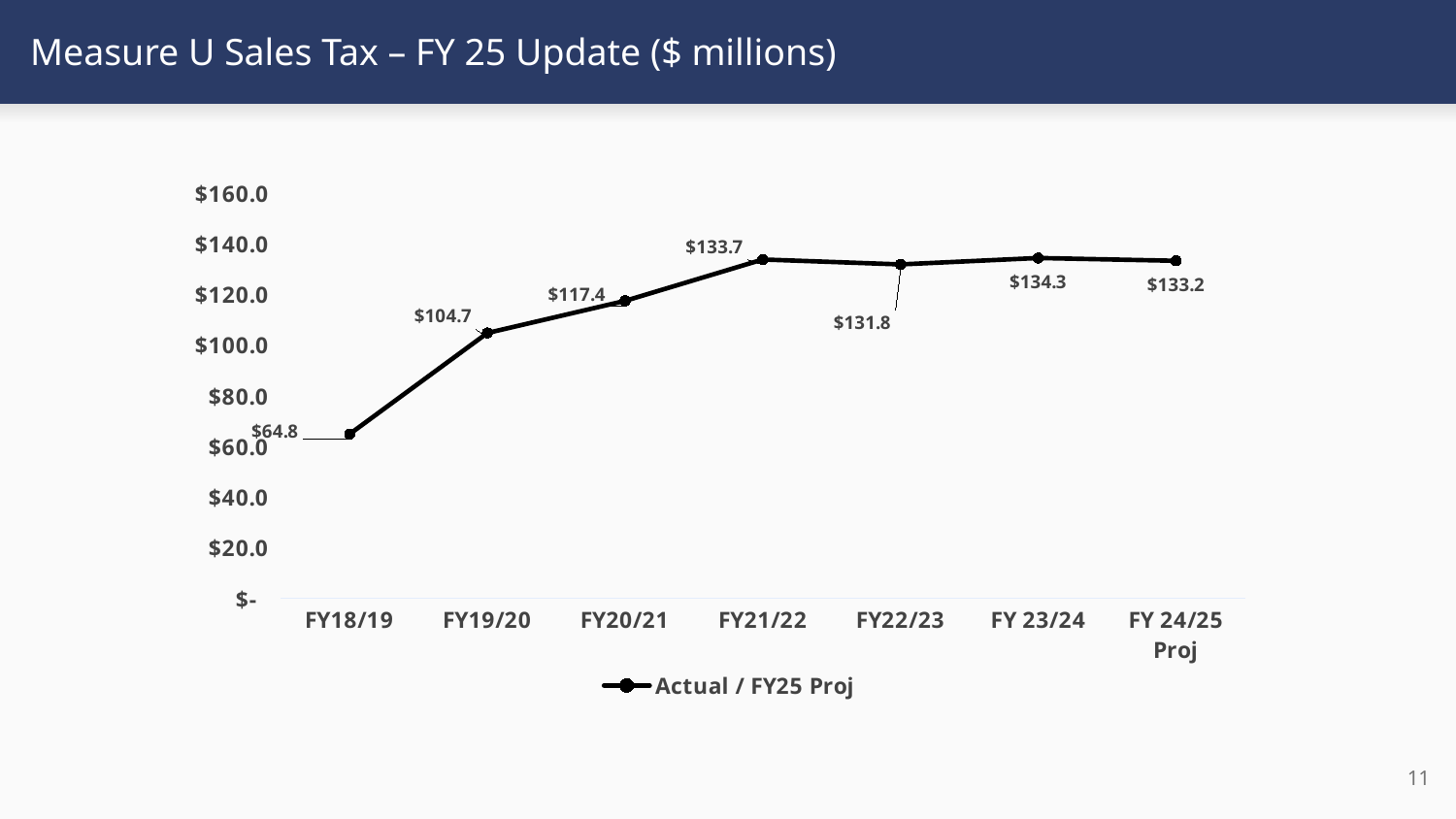
How many fiscal years are plotted on the x axis? 7 What is the value for FY21/22? $133.7 Which fiscal year has the lowest value? FY18/19 What is the value for FY18/19? $64.8 Which fiscal year has the highest value? FY 23/24 What kind of chart is shown? line chart What is the legend entry for the plotted series? Actual / FY25 Proj What is the value for FY 24/25 Proj? $133.2 Which is larger, the value for FY20/21 or the value for FY22/23? FY22/23 Is the value for FY19/20 greater or less than $100.0? greater What is the difference between the values for FY19/20 and FY18/19? $39.9 How many series does the legend list? 1